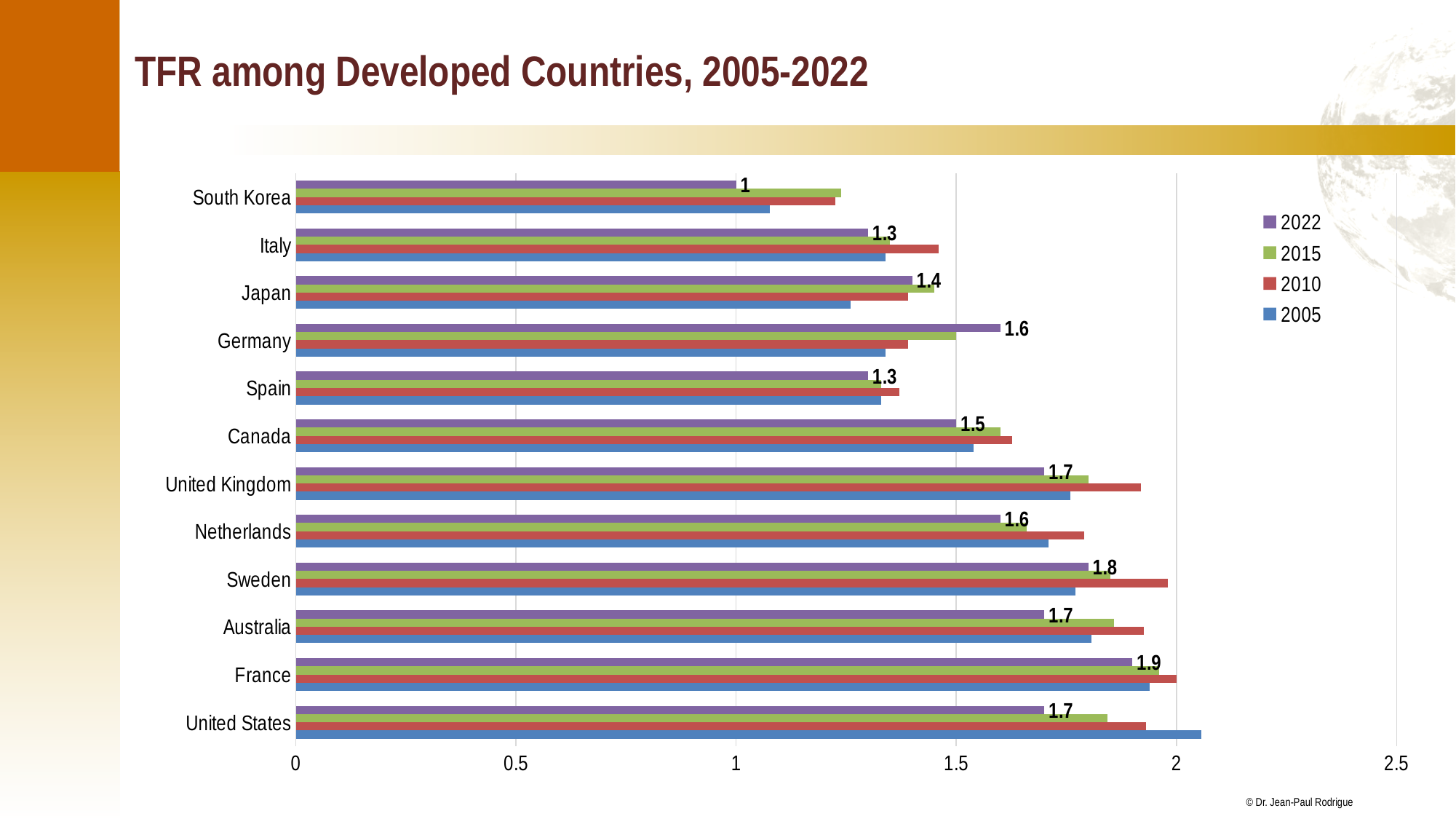
What is the 2022 TFR value shown for Germany? 1.6 Which country has the lowest 2022 TFR value? South Korea What is the 2022 TFR value shown for South Korea? 1 What is the 2022 TFR value shown for France? 1.9 What is the difference between the 2022 TFR values of France and South Korea? 0.9 How many countries are shown on the chart? 12 Is the 2010 value for the United Kingdom greater or less than 1.5? greater How many series does the legend list? 4 What kind of chart is shown on the slide? Bar chart Which country has the highest 2022 TFR value? France Which has a higher 2022 TFR value, Sweden or Canada? Sweden Is the 2005 value for South Korea greater or less than 1.5? less